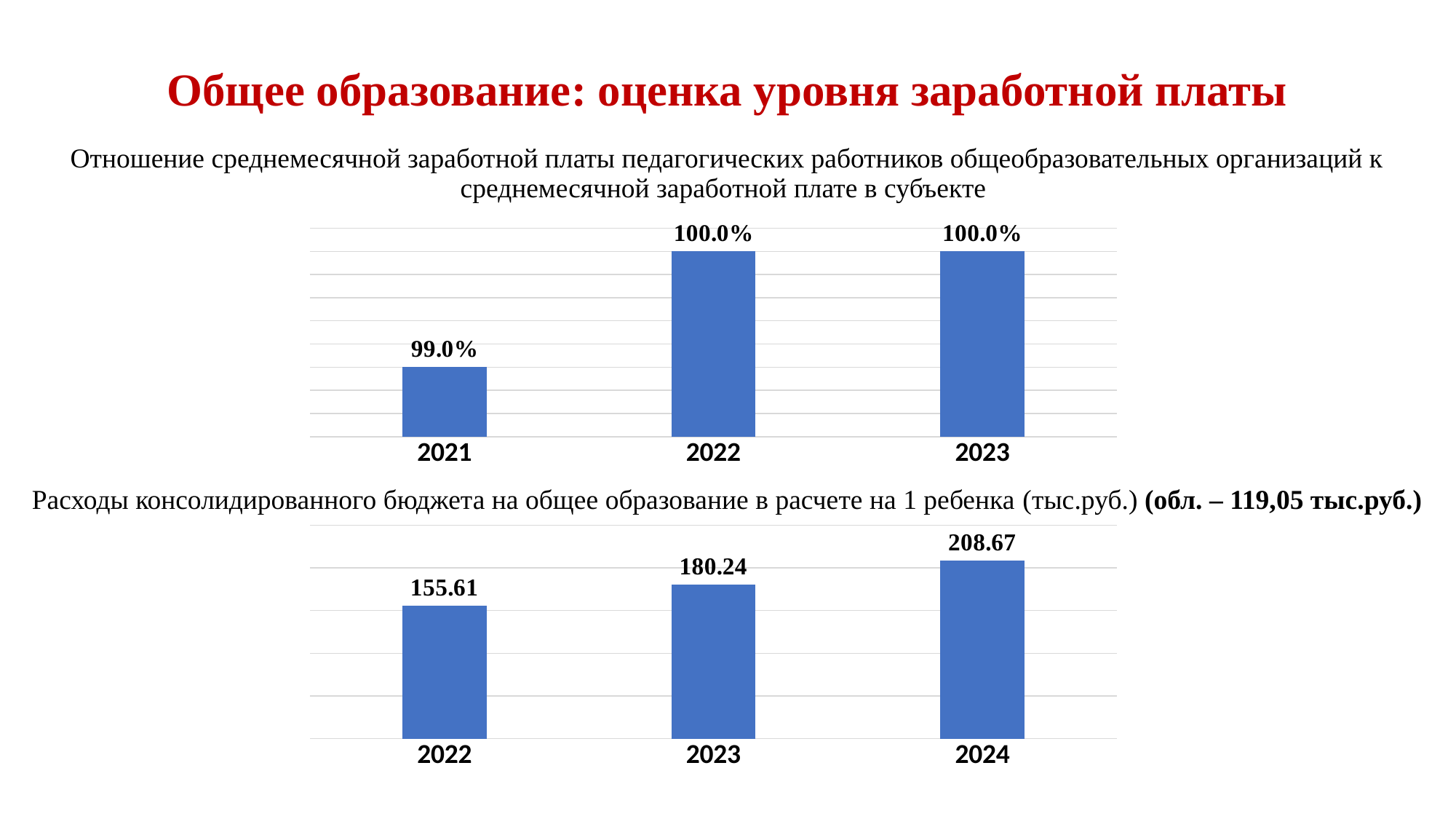
In the bottom chart (expenses per child), which is larger, the value for 2022 or 2023? 2023 In the bottom chart (expenses per child), what is the regional (обл.) value stated in the chart title? 119,05 тыс.руб. In the bottom chart (expenses per child), what is the value for 2023? 180.24 In the bottom chart (expenses per child), which year has the highest value? 2024 In the top chart (salary ratio), what is the value for 2021? 99.0% In the top chart (salary ratio), what is the value for 2022? 100.0% In the bottom chart (expenses per child), what is the difference between the 2024 and 2022 values? 53.06 In the top chart (salary ratio), what kind of chart is used? Bar chart In the bottom chart (expenses per child), do the values rise or fall from 2022 to 2024? Rise In the top chart (salary ratio), how many years are shown? 3 In the bottom chart (expenses per child), what is the value for 2024? 208.67 In the top chart (salary ratio), which year has the lowest value? 2021